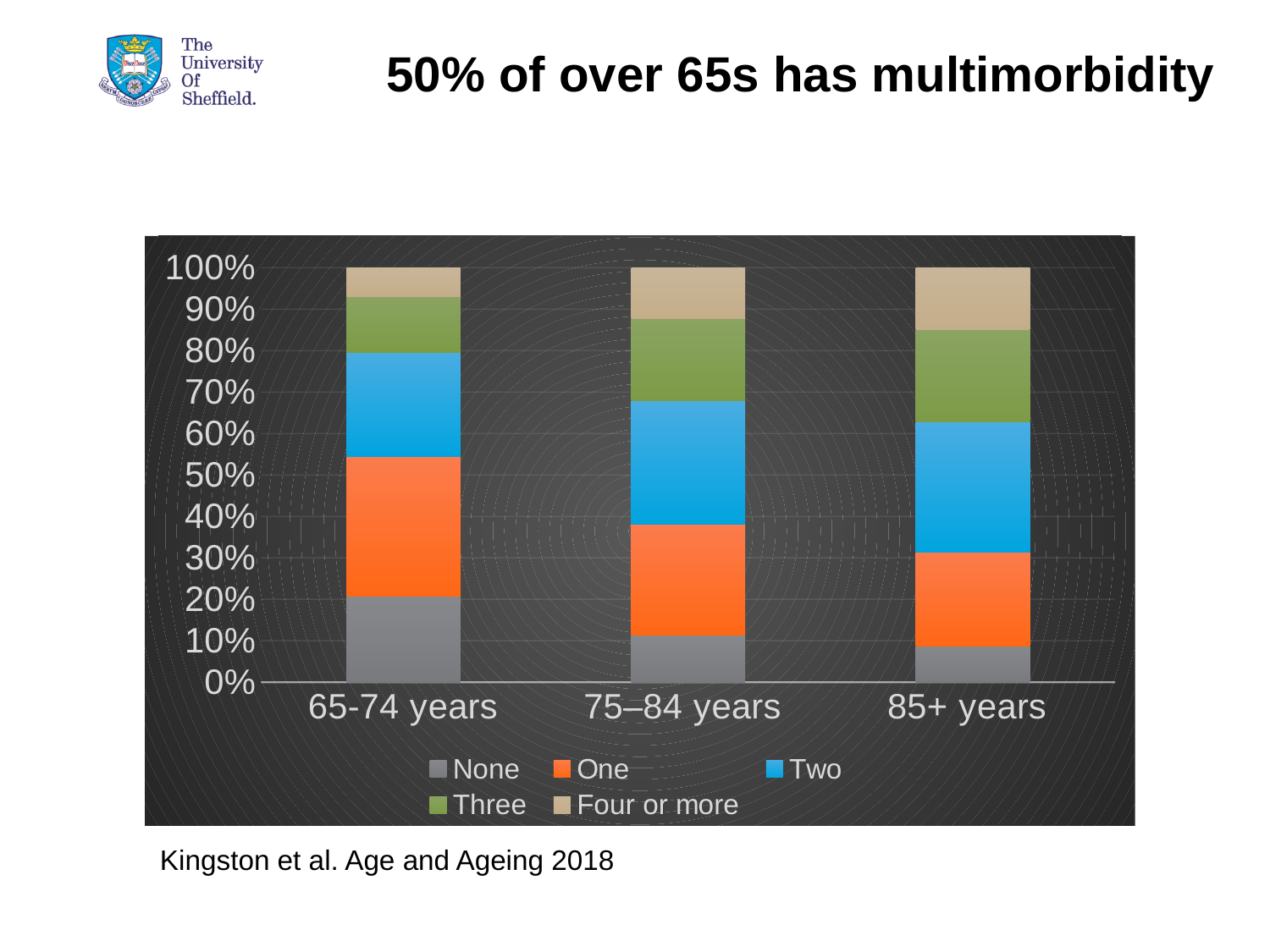
How many age groups are shown on the x axis? 3 Which age group has the largest 'None' segment? 65-74 years Is the 'None' segment for 65-74 years greater or less than 30%? less Is the 'None' segment for 75–84 years greater or less than 20%? less Is the 'Four or more' segment for 85+ years greater or less than 10%? greater How many series does the legend list? 5 Is the 'One' segment larger for 65-74 years or for 85+ years? 65-74 years What is the title of the slide containing the chart? 50% of over 65s has multimorbidity What kind of chart is shown on the slide? Stacked bar chart Does the 'None' share rise or fall as age group increases along the x axis? fall Which series is shown in orange in the legend? One